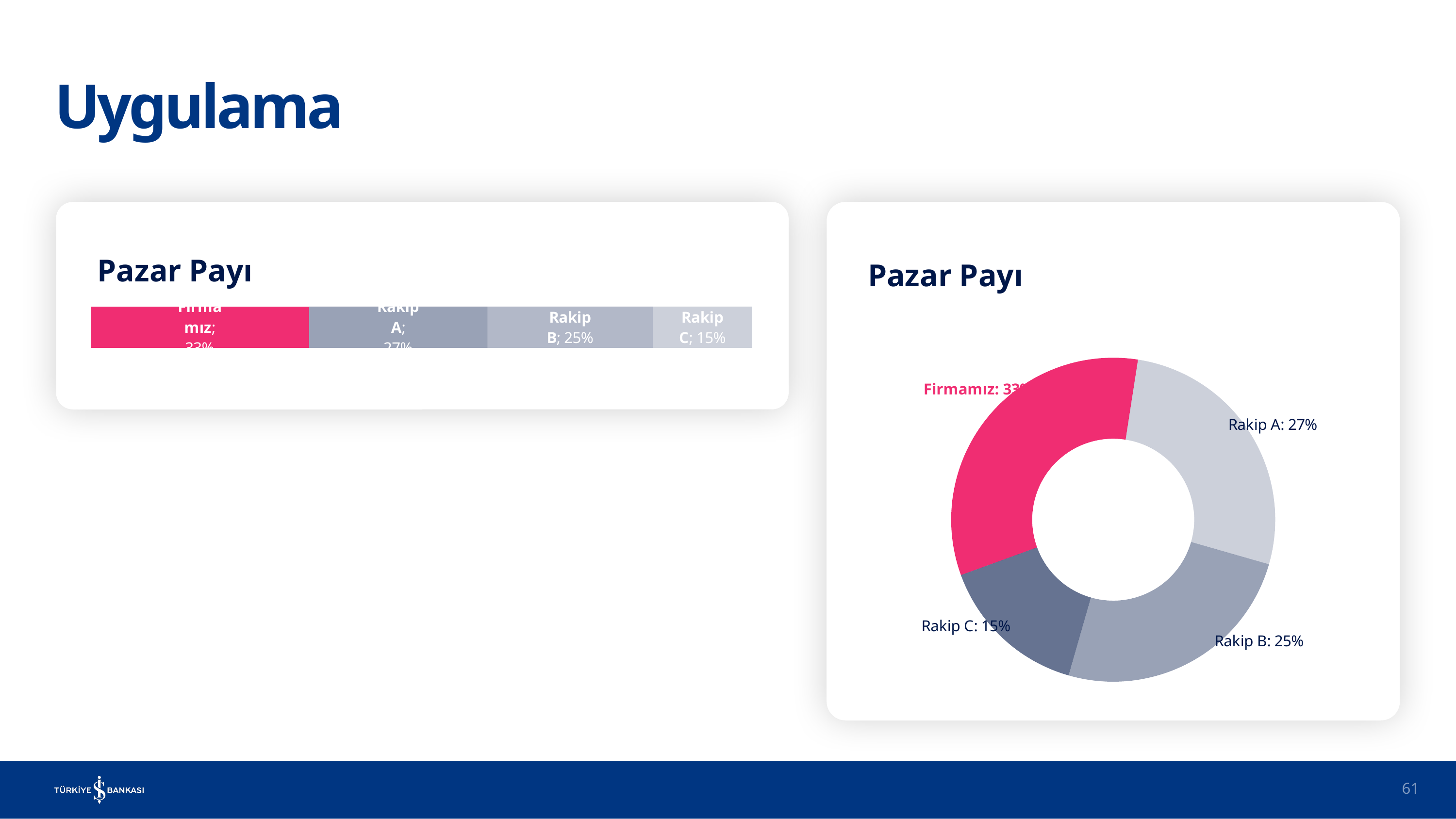
In the bar chart on the left, what is the value for Rakip C? 15% In the donut chart on the right, which category has the largest share? Firmamız In the donut chart on the right, what is the share for Rakip A? 27% In the donut chart on the right, what is the share for Rakip B? 25% What kind of chart is shown on the left side of the slide? bar chart How many categories are shown in the donut chart on the right? 4 In the donut chart on the right, which category has the smallest share? Rakip C In the bar chart on the left, what is the value for Rakip B? 25% In the donut chart on the right, what is the difference between the shares of Rakip A and Rakip C? 12% What kind of chart is shown on the right side of the slide? donut chart In the donut chart on the right, what is the share for Rakip C? 15% In the donut chart on the right, which is larger, the share of Rakip B or Rakip C? Rakip B